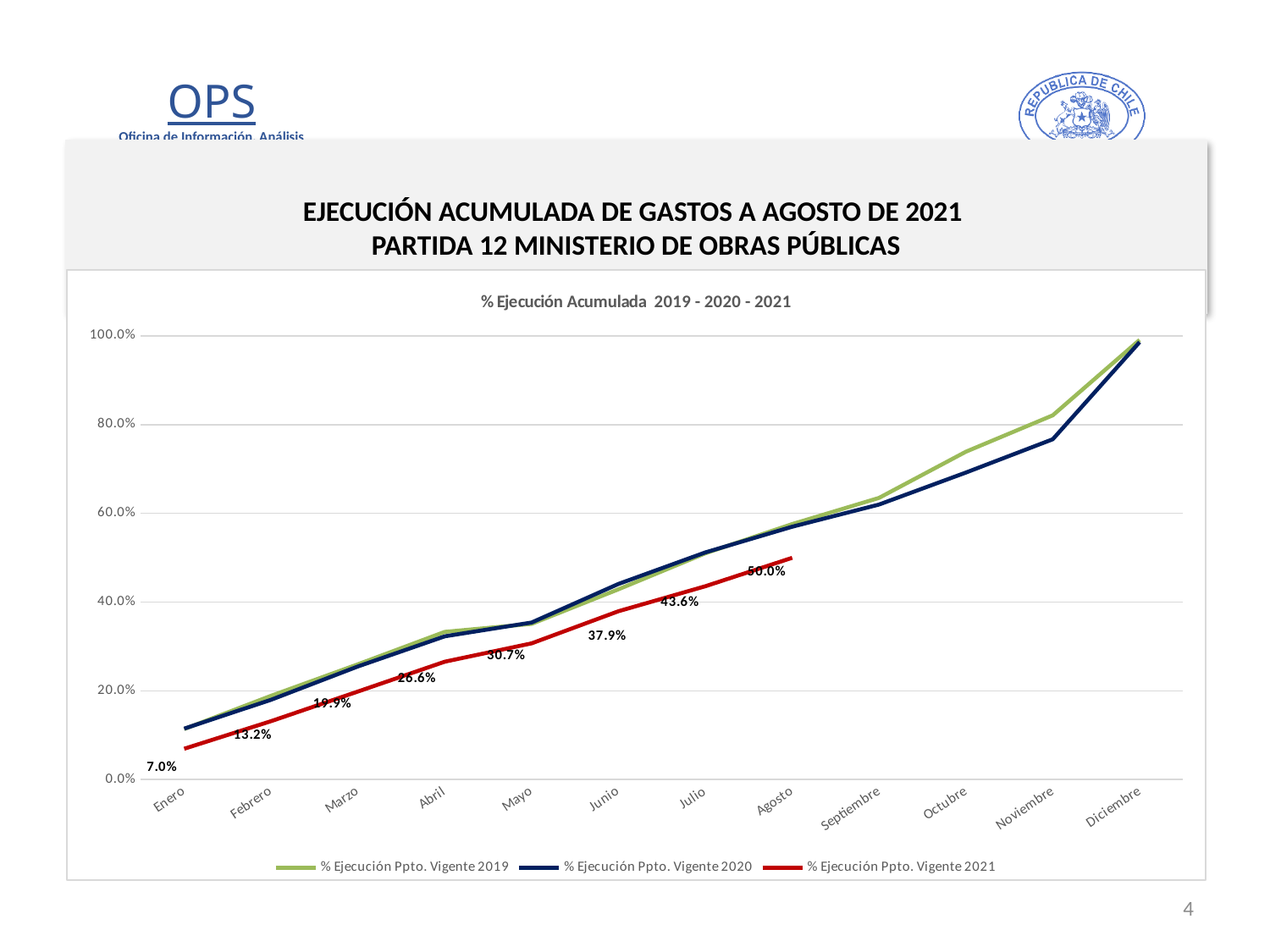
What kind of chart is shown on the slide? line chart What is the value for Agosto in the % Ejecución Ppto. Vigente 2021 series? 50.0% Do the values in the % Ejecución Ppto. Vigente 2021 series rise or fall from Enero to Agosto? rise What is the value for Mayo in the % Ejecución Ppto. Vigente 2021 series? 30.7% How many months are shown on the x axis? 12 How many series does the legend list? 3 What is the difference between the Agosto and Enero values in the % Ejecución Ppto. Vigente 2021 series? 43.0% Is the value for Diciembre in the % Ejecución Ppto. Vigente 2019 series greater or less than 80.0%? greater What is the difference between the Julio and Junio values in the % Ejecución Ppto. Vigente 2021 series? 5.7% Which month has the highest value in the % Ejecución Ppto. Vigente 2021 series? Agosto What is the value for Enero in the % Ejecución Ppto. Vigente 2021 series? 7.0% What is the value for Marzo in the % Ejecución Ppto. Vigente 2021 series? 19.9%